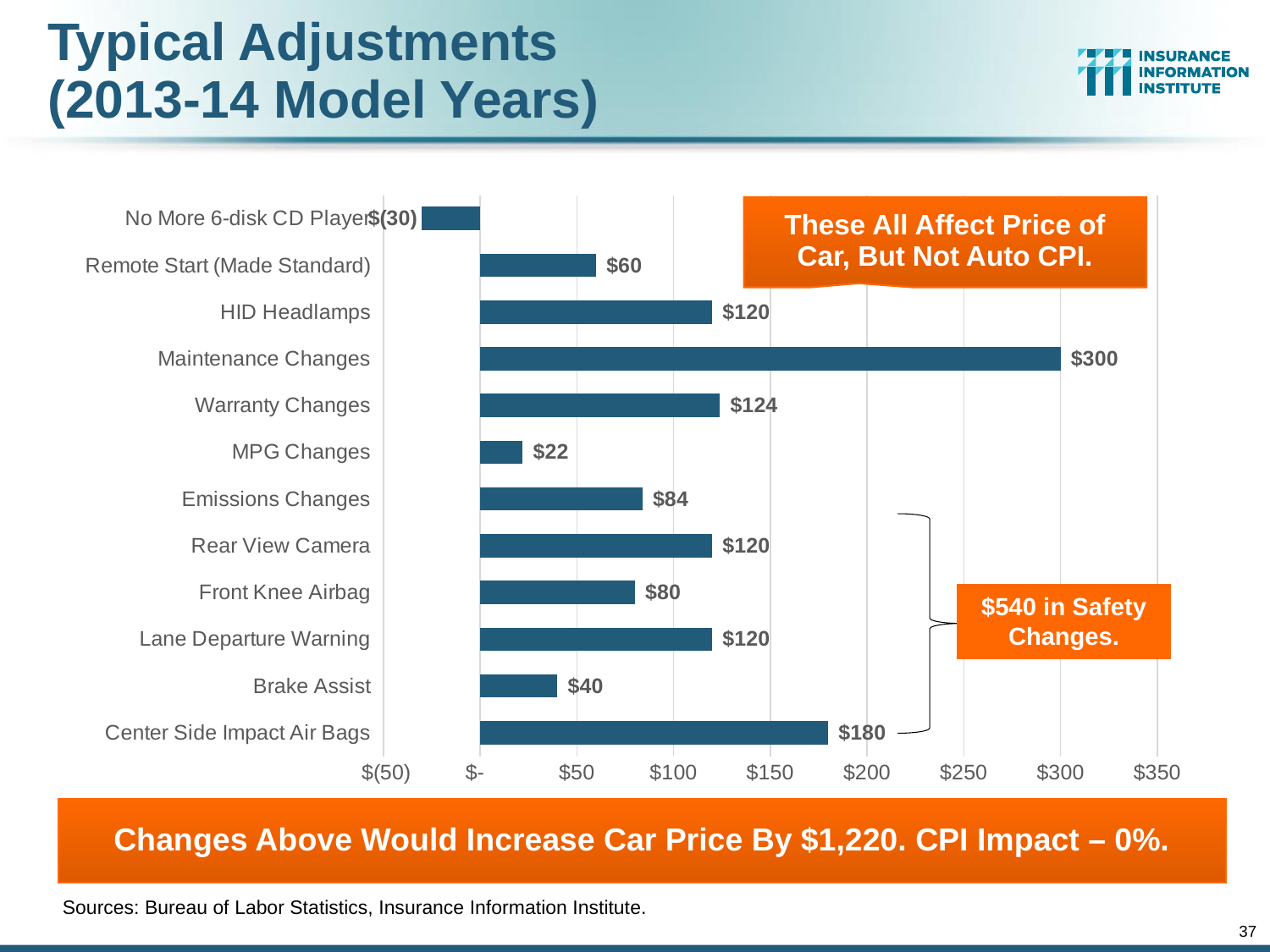
What is the value for Maintenance Changes? $300 Which is larger, Emissions Changes or Remote Start (Made Standard)? Emissions Changes Which category has the lowest value? No More 6-disk CD Player What is the difference between Rear View Camera and Brake Assist? $80 What is the value for MPG Changes? $22 What is the value for No More 6-disk CD Player? $(30) Which category has the highest value? Maintenance Changes What is the value for Center Side Impact Air Bags? $180 What is the difference between Maintenance Changes and Center Side Impact Air Bags? $120 How many categories are shown in the chart? 12 What kind of chart is shown on the slide? Bar chart According to the callout on the chart, how much do the safety changes total? $540